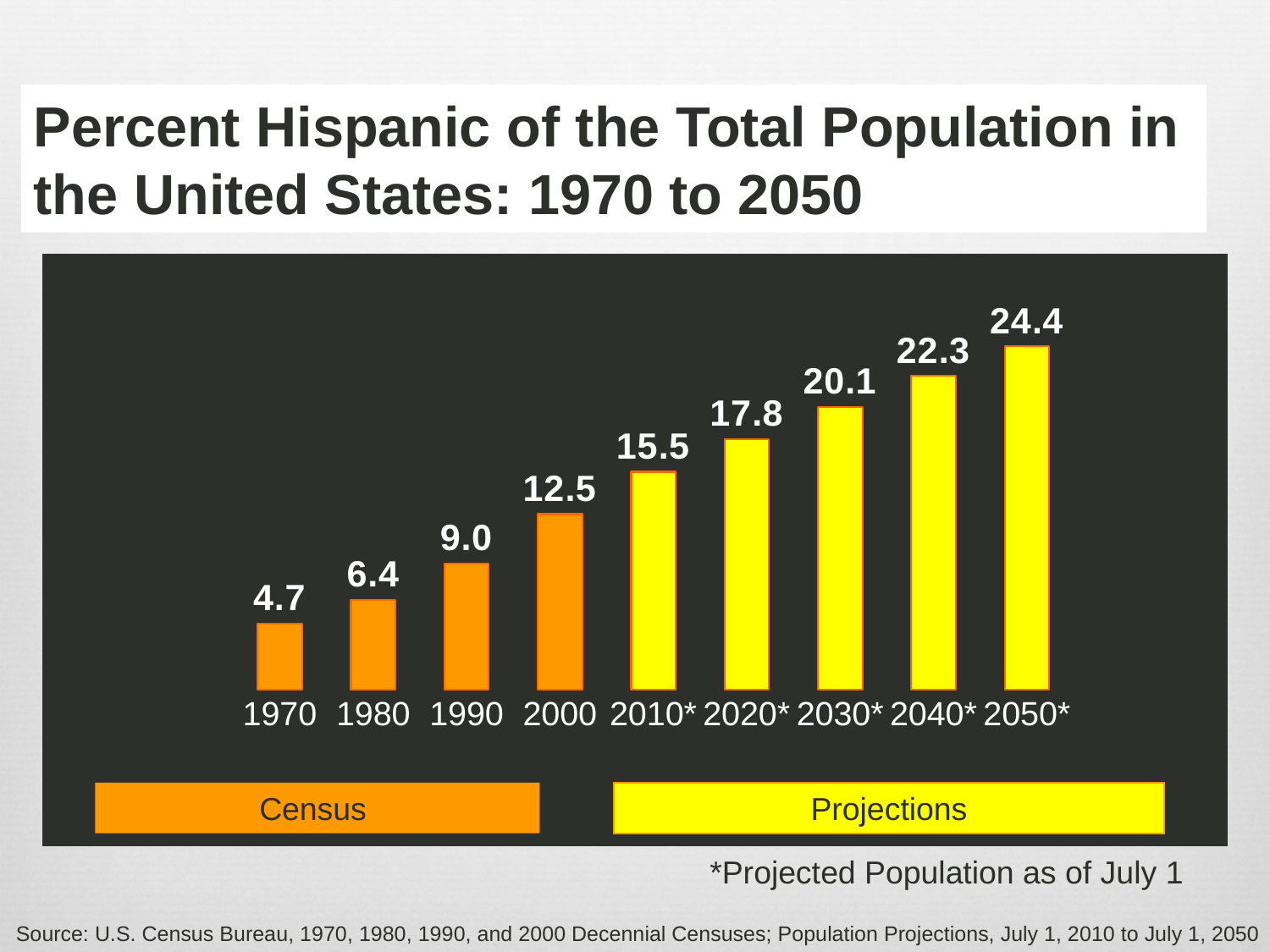
Which year has the lowest value? 1970 What kind of chart is this? bar chart Which year has the highest value? 2050* What is the value for 2000? 12.5 How many bars are shown in the chart? 9 Which is larger, the value for 1980 or the value for 2010*? 2010* What is the value for 2030*? 20.1 What is the difference between the values for 2000 and 1990? 3.5 What is the difference between the values for 2050* and 1970? 19.7 What is the value for 1970? 4.7 Do the values rise or fall from 1970 to 2050*? rise What colour are the bars labelled as Projections? yellow